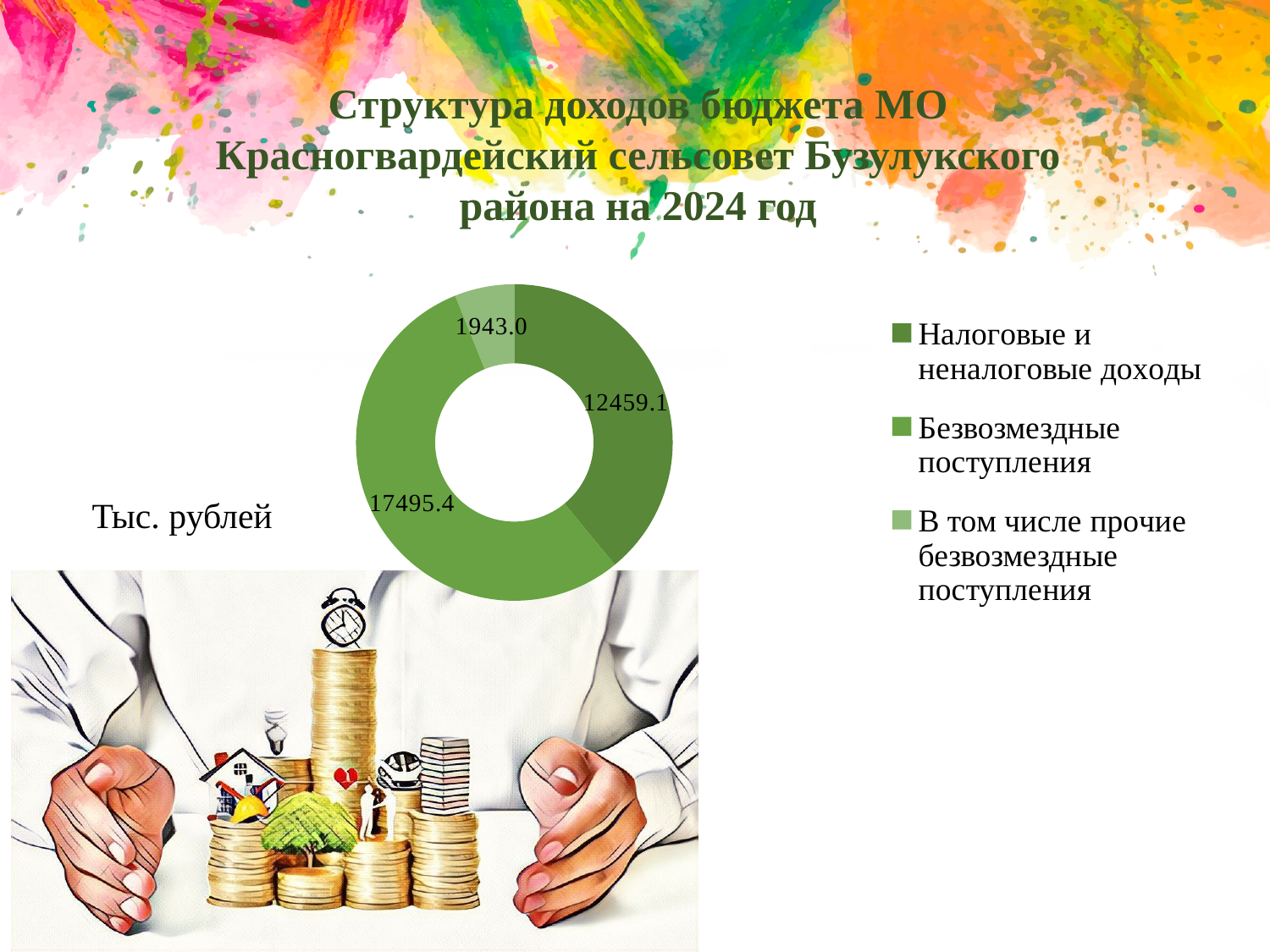
What is the difference between Налоговые и неналоговые доходы and В том числе прочие безвозмездные поступления? 10516.1 What is the value for В том числе прочие безвозмездные поступления? 1943.0 Which category has the smallest value in the chart? В том числе прочие безвозмездные поступления Which is larger: Налоговые и неналоговые доходы or Безвозмездные поступления? Безвозмездные поступления In what units are the chart values given, according to the label next to the chart? Тыс. рублей How many entries does the legend list? 3 What kind of chart is shown on the slide? doughnut chart What is the value for Налоговые и неналоговые доходы? 12459.1 Which category has the largest value in the chart? Безвозмездные поступления How many slices does the chart have? 3 What is the difference between Безвозмездные поступления and Налоговые и неналоговые доходы? 5036.3 What is the value for Безвозмездные поступления? 17495.4